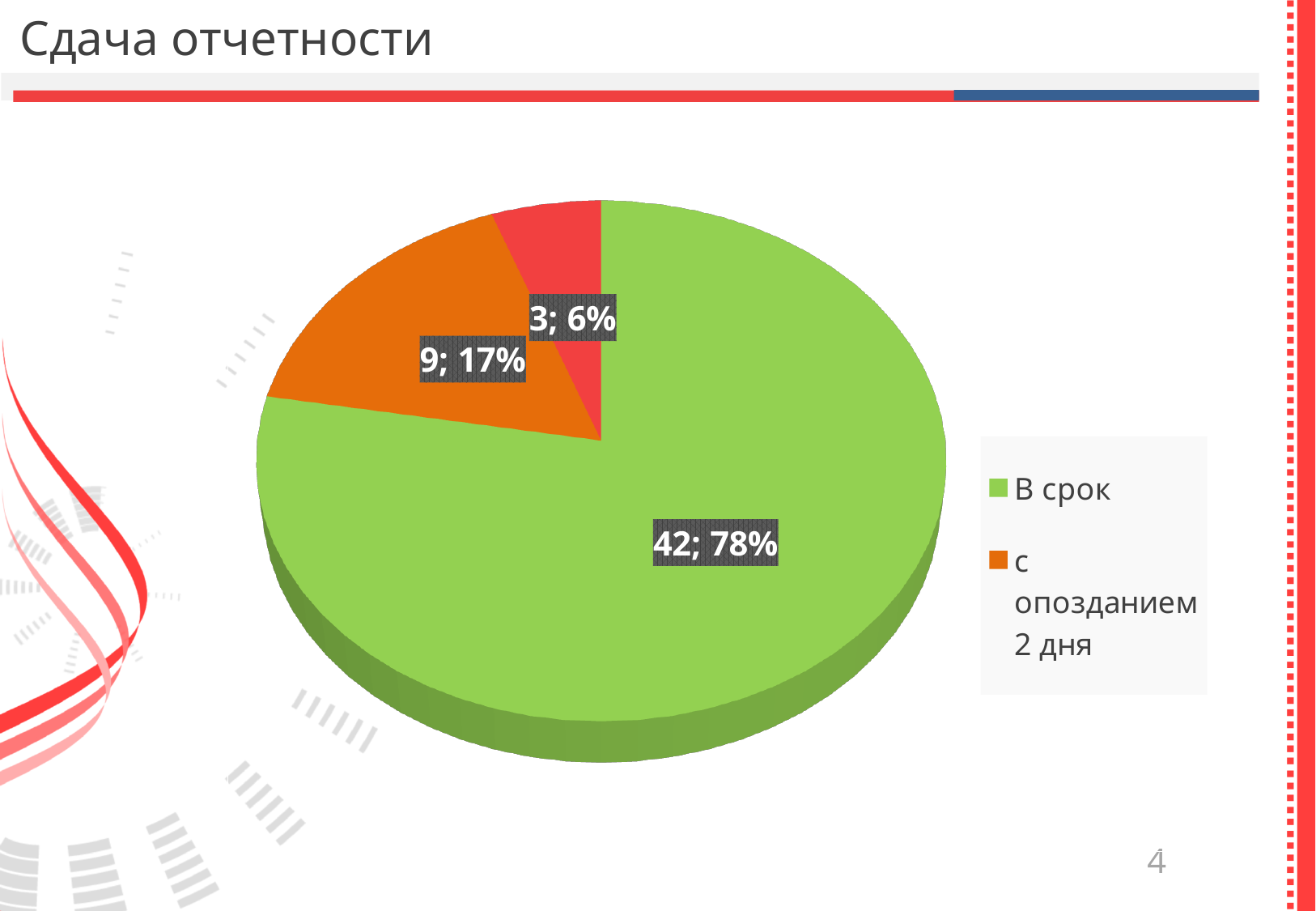
What kind of chart is shown on the slide? pie chart How many entries does the legend list? 2 What colour is the "В срок" slice? green What share of the pie does the "В срок" slice represent? 78% What value is shown for the "с опозданием 2 дня" slice? 9 What is the difference between the values for "В срок" and "с опозданием 2 дня"? 33 What is the title of the slide with the pie chart? Сдача отчетности Which slice of the pie is the largest? В срок What share of the pie does the "с опозданием 2 дня" slice represent? 17% How many slices does the pie chart have? 3 What value is shown for the "В срок" slice? 42 Which is larger, the "В срок" slice or the "с опозданием 2 дня" slice? В срок